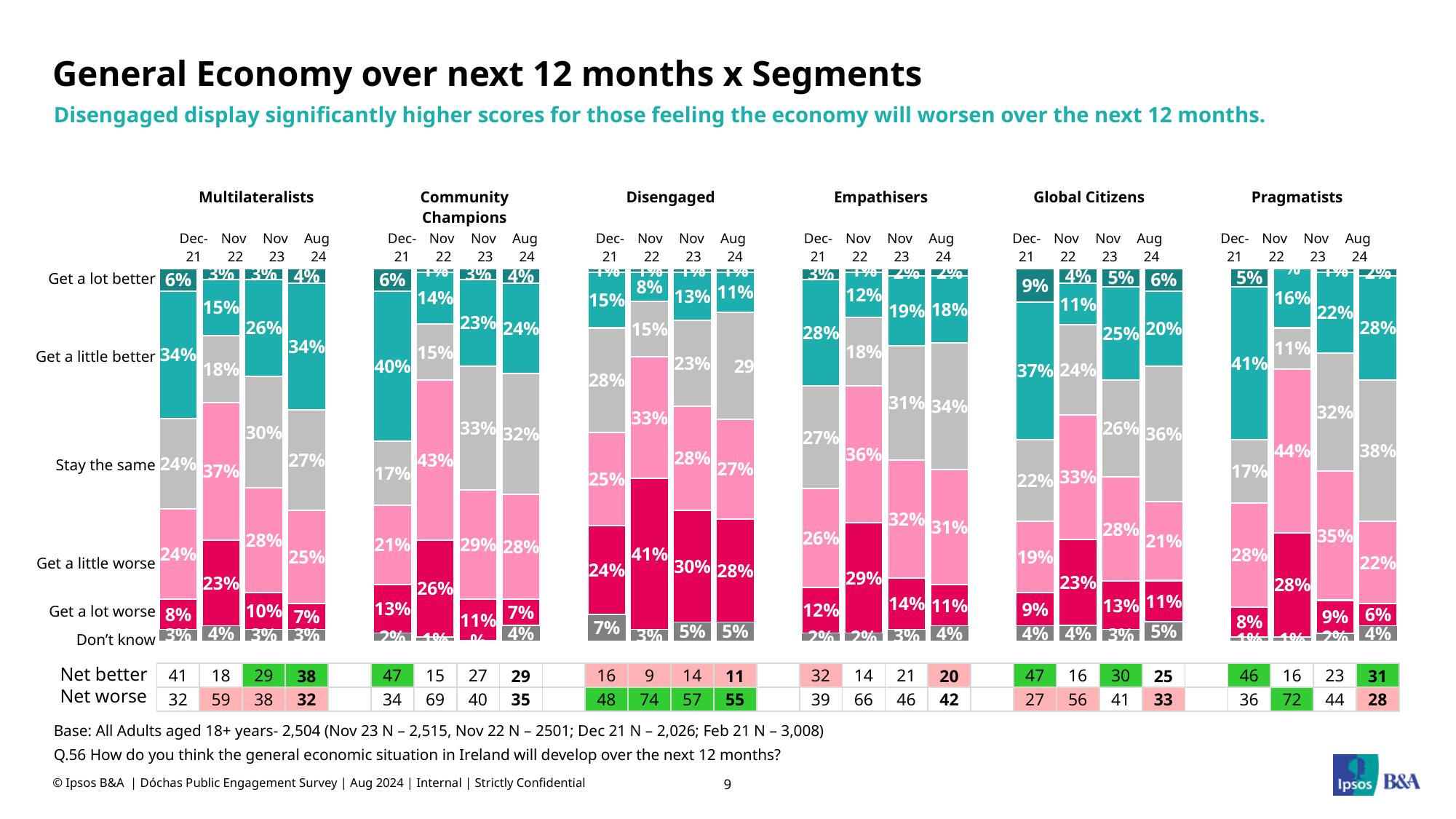
In the Pragmatists chart, what percentage said 'Get a little worse' in Nov 22? 44% In the Multilateralists chart, what percentage said 'Get a little better' in Dec-21? 34% What kind of chart is used to show the segment results? Stacked bar chart How many time points are shown for each segment chart? 4 In the Disengaged chart, what percentage said the economy will 'Get a lot worse' in Nov 22? 41% In the Global Citizens chart, what percentage said 'Get a lot better' in Dec-21? 9% For Dec-21, which segment has the larger 'Get a little better' share: Global Citizens or Pragmatists? Pragmatists In the Disengaged chart, what is the difference in percentage points between the 'Get a lot worse' share in Nov 22 and in Aug 24? 13 In the Multilateralists chart, which time point has the lowest 'Get a lot worse' share? Aug 24 In the Multilateralists chart, does the 'Get a little better' share rise or fall from Nov 22 to Aug 24? Rise In the Empathisers chart, what percentage said 'Stay the same' in Aug 24? 34% In the Disengaged chart, which time point has the highest 'Get a lot worse' share? Nov 22